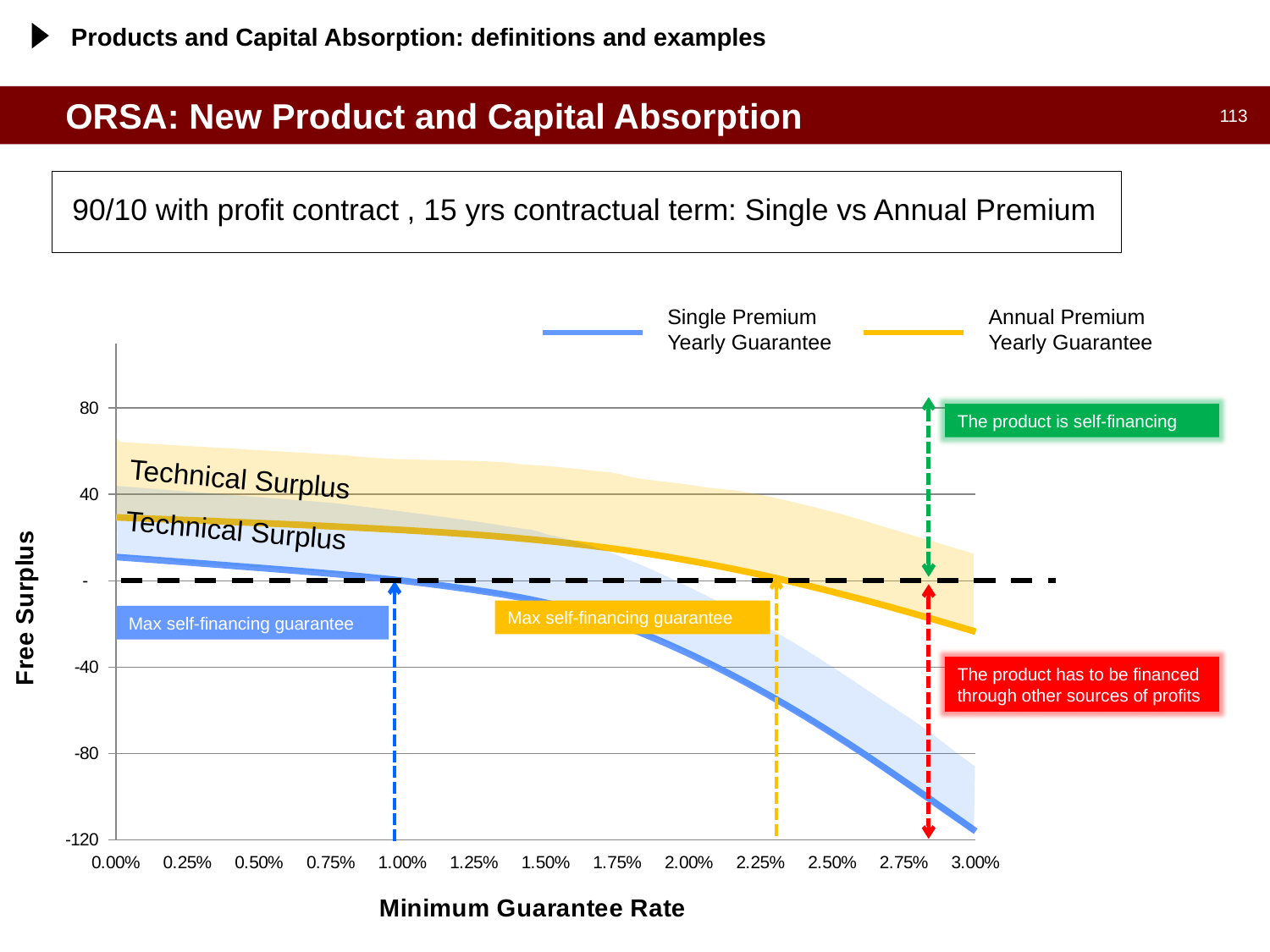
What is the title of the y axis? Free Surplus At a Minimum Guarantee Rate of 2.00%, which series has the higher Free Surplus? Annual Premium Yearly Guarantee How many tick labels are shown on the x axis? 13 Does the Single Premium Yearly Guarantee line rise or fall as the Minimum Guarantee Rate increases? fall What kind of chart is shown on the slide? line chart Is the Free Surplus for Annual Premium Yearly Guarantee at 3.00% greater or less than -40? greater Is the Free Surplus for Annual Premium Yearly Guarantee at 0.00% greater or less than 40? less Is the Free Surplus for Single Premium Yearly Guarantee at 3.00% greater or less than -80? less At a Minimum Guarantee Rate of 0.50%, which series has the lower Free Surplus? Single Premium Yearly Guarantee What is the title of the x axis? Minimum Guarantee Rate Does the Annual Premium Yearly Guarantee line rise or fall as the Minimum Guarantee Rate increases? fall How many series does the legend list? 2